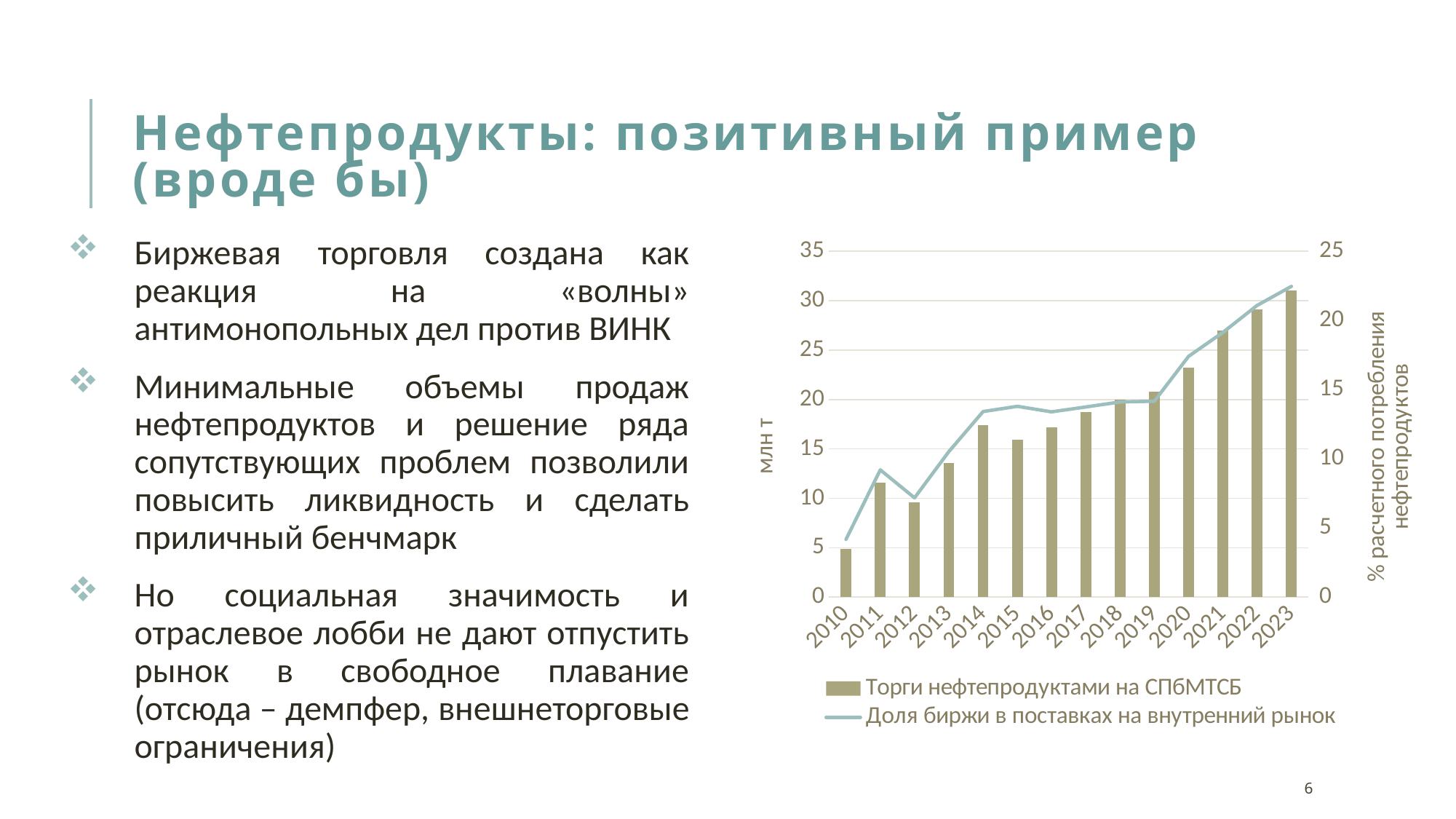
Which bar is taller, 2014 or 2015? 2014 Which bar is taller, 2011 or 2012? 2011 Overall, do the bars for Торги нефтепродуктами на СПбМТСБ rise or fall from 2010 to 2023? Rise Is the bar value for 2023 greater or less than 30 млн т? greater Is the bar value for 2020 greater or less than 25 млн т? less Which year has the highest bar for Торги нефтепродуктами на СПбМТСБ? 2023 What is the unit label on the left vertical axis of the chart? млн т How many years are shown on the x axis of the chart? 14 How many series does the chart legend list? 2 Which year has the lowest bar for Торги нефтепродуктами на СПбМТСБ? 2010 What kind of chart is shown on the slide? A combined bar and line chart